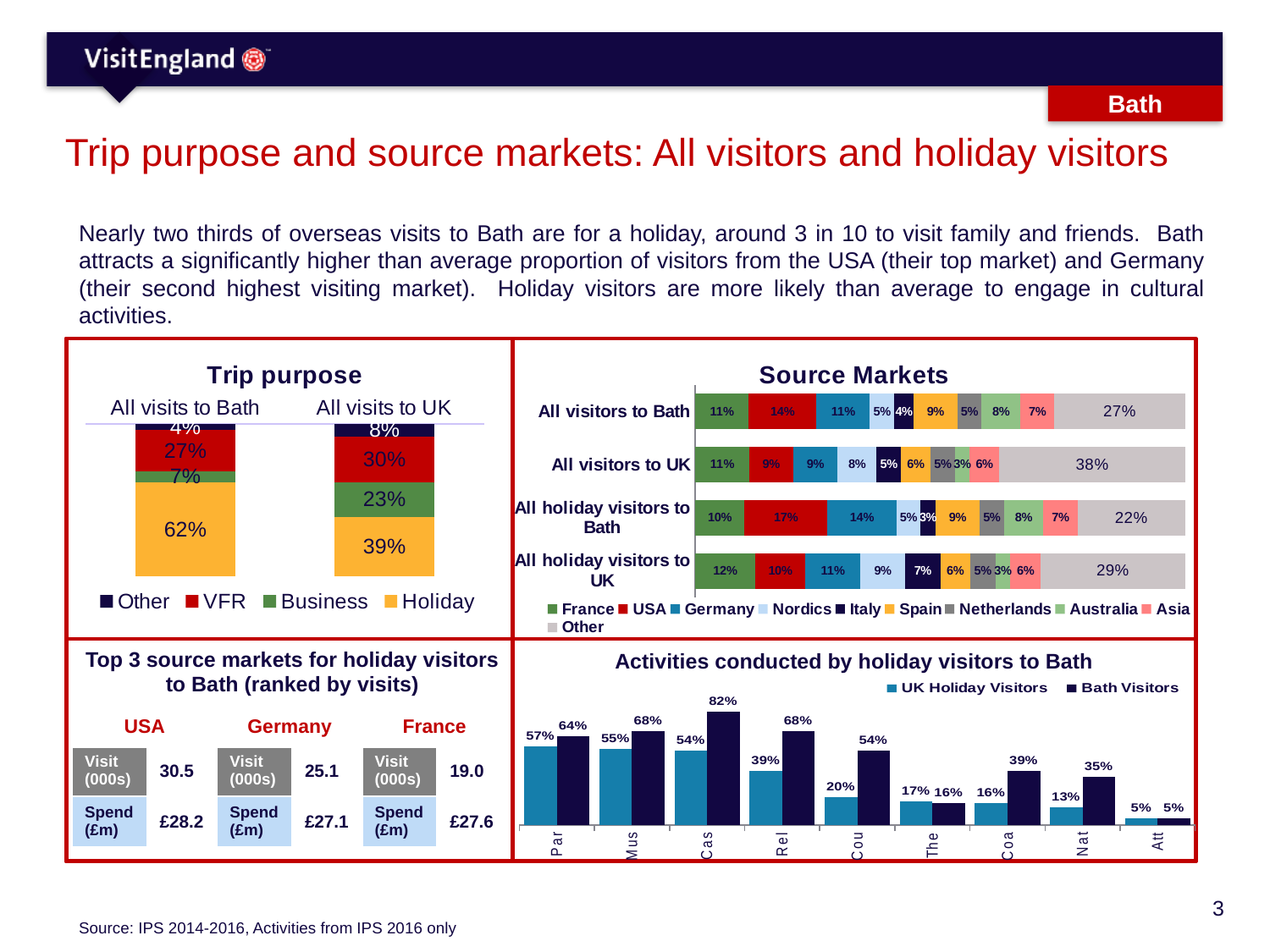
In the Trip purpose chart, what percentage of all visits to Bath are for a holiday? 62% In the Source Markets chart, what is the Other share for all visitors to the UK? 38% In the Top 3 source markets for holiday visitors to Bath panel, what is the spend (£m) for Germany? £27.1 In the Activities conducted by holiday visitors to Bath chart, which category has the highest Bath Visitors value? Cas In the Source Markets chart, what share of all visitors to Bath come from the USA? 14% In the Trip purpose chart, how many series does the legend list? 4 In the Source Markets chart, which is larger: the USA share of all holiday visitors to Bath or the USA share of all holiday visitors to the UK? All holiday visitors to Bath In the Trip purpose chart, what is the Business share for all visits to the UK? 23% In the Trip purpose chart, what is the difference between the Holiday share for all visits to Bath and for all visits to the UK? 23 percentage points In the Activities conducted by holiday visitors to Bath chart, what is the Bath Visitors value for the category labelled 'Cas'? 82% What kind of chart is the Activities conducted by holiday visitors to Bath chart? Bar chart In the Source Markets chart, how many series does the legend list? 10